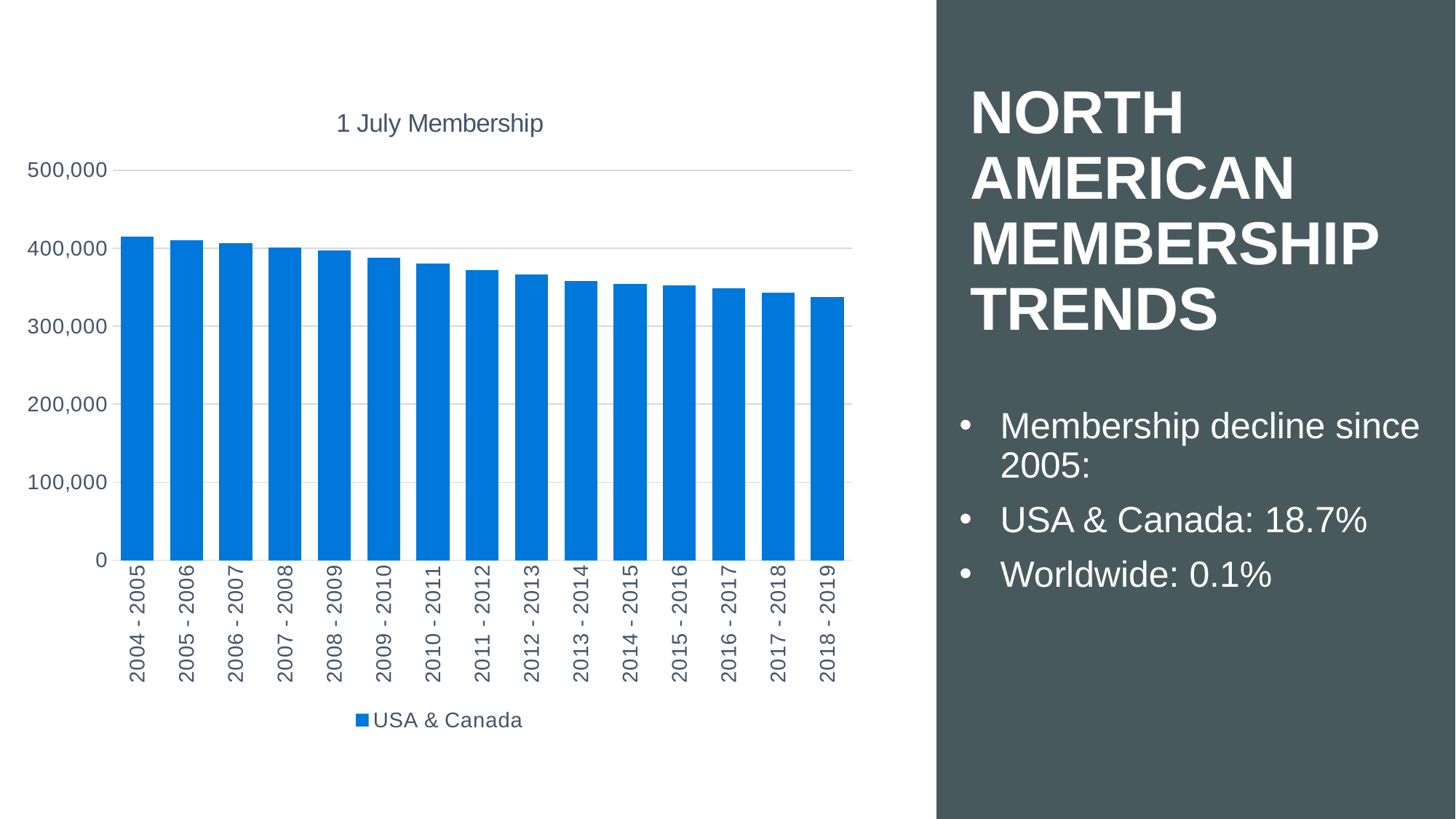
Is the value for 2004 - 2005 greater or less than 400,000? greater Do the membership values rise or fall from 2004 - 2005 to 2018 - 2019? fall What is the title of the chart? 1 July Membership What series does the chart's legend list? USA & Canada Which is larger, the value for 2010 - 2011 or the value for 2015 - 2016? 2010 - 2011 Which membership year has the lowest bar? 2018 - 2019 How many membership years are plotted on the x axis? 15 Is the value for 2012 - 2013 greater or less than 300,000? greater What kind of chart is shown on the slide? bar chart Which membership year has the highest bar? 2004 - 2005 How many series does the legend list? 1 Is the value for 2018 - 2019 greater or less than 400,000? less